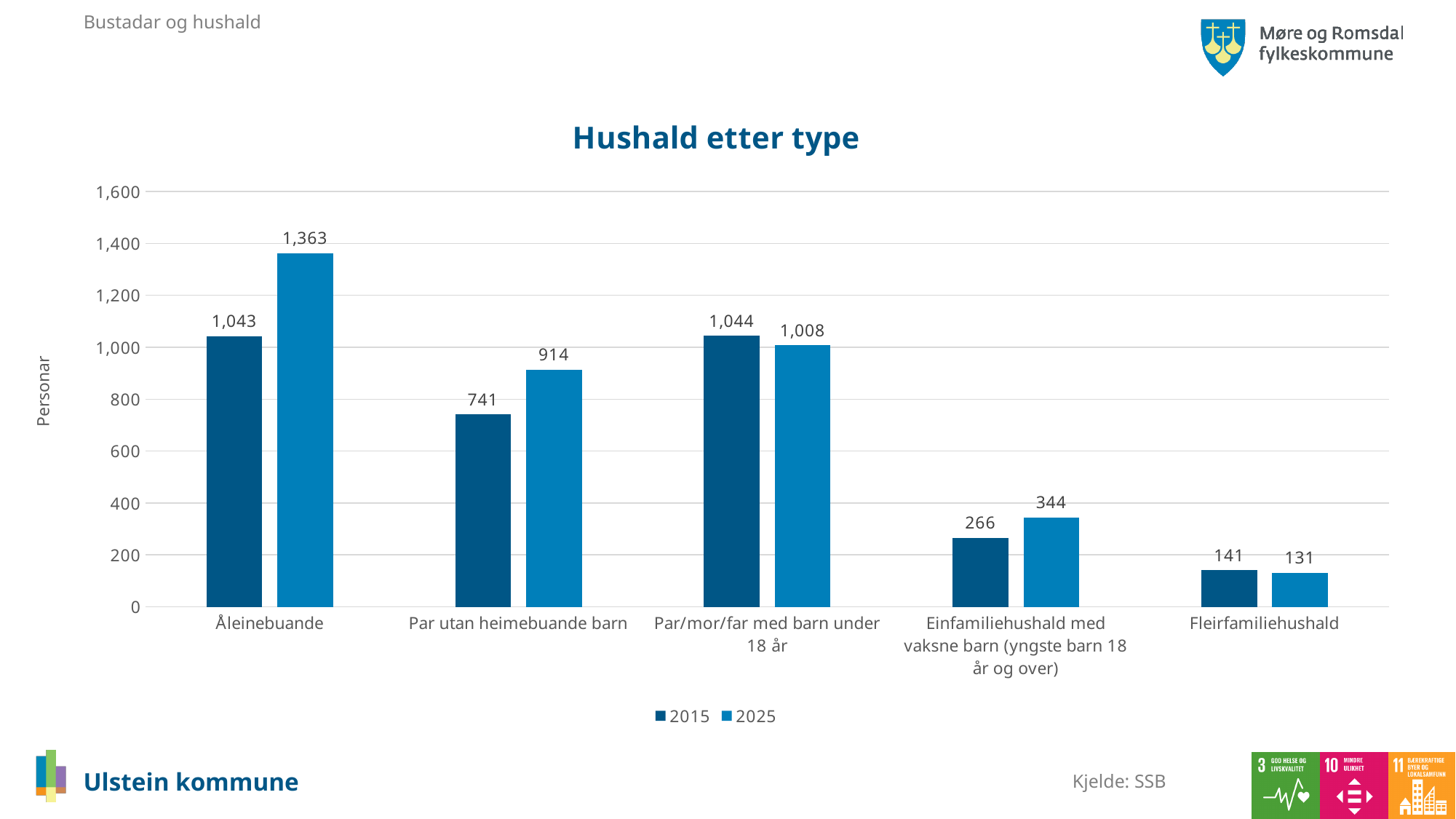
Which category has the highest value in 2025? Åleinebuande What is the title of the chart? Hushald etter type How many household categories are shown on the x axis? 5 How many series does the legend list? 2 Which category has the lowest value in 2015? Fleirfamiliehushald What is the value for Fleirfamiliehushald in 2025? 131 What is the value for Åleinebuande in 2025? 1,363 What is the difference between the 2025 and 2015 values for Åleinebuande? 320 What is the value for Par utan heimebuande barn in 2015? 741 Which is larger for Einfamiliehushald med vaksne barn (yngste barn 18 år og over): the 2015 value or the 2025 value? 2025 What kind of chart is shown? Bar chart What is the difference between the 2015 and 2025 values for Par/mor/far med barn under 18 år? 36